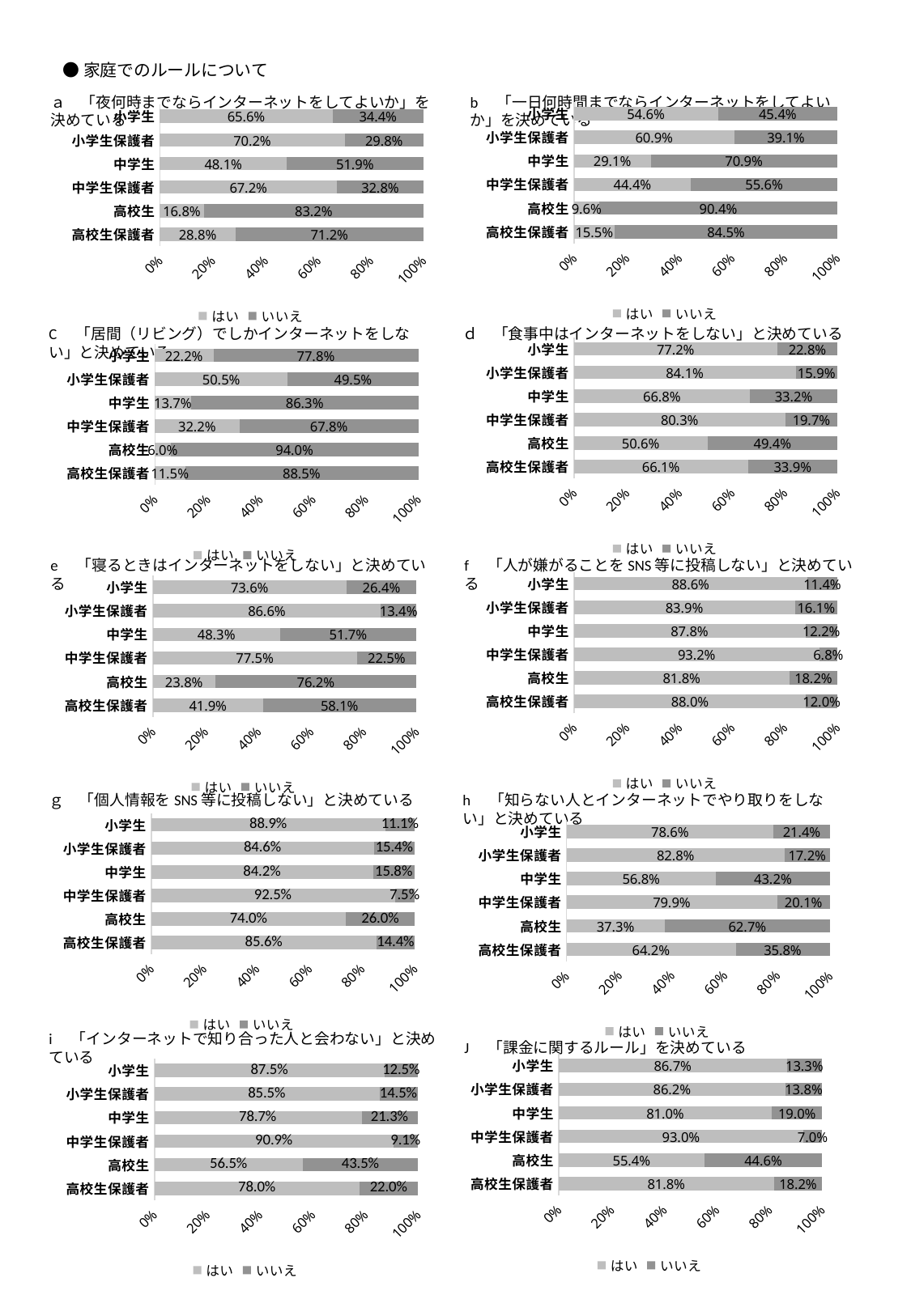
In chart c (「居間（リビング）でしかインターネットをしない」と決めている), what are the two legend entries? はい, いいえ In chart h (「知らない人とインターネットでやり取りをしない」と決めている), is the はい value for 高校生 greater or less than 40%? less In chart d (「食事中はインターネットをしない」と決めている), what is the difference between the はい values for 小学生保護者 and 高校生? 33.5% In chart j (「課金に関するルール」を決めている), which category has the highest はい value? 中学生保護者 In chart j (「課金に関するルール」を決めている), how many series does the legend list? 2 In chart a (「夜何時までならインターネットをしてよいか」を決めている), what is the はい value for 高校生? 16.8% What kind of chart is chart i (「インターネットで知り合った人と会わない」と決めている)? bar chart In chart g (「個人情報を SNS 等に投稿しない」と決めている), how many categories are shown on the vertical axis? 6 In chart c (「居間（リビング）でしかインターネットをしない」と決めている), what is the はい value for 高校生? 6.0% In chart e (「寝るときはインターネットをしない」と決めている), for 中学生, which is larger: はい or いいえ? いいえ In chart b (「一日何時間までならインターネットをしてよいか」を決めている), which category has the highest いいえ value? 高校生 In chart f (「人が嫌がることを SNS 等に投稿しない」と決めている), which category has the lowest いいえ value? 中学生保護者